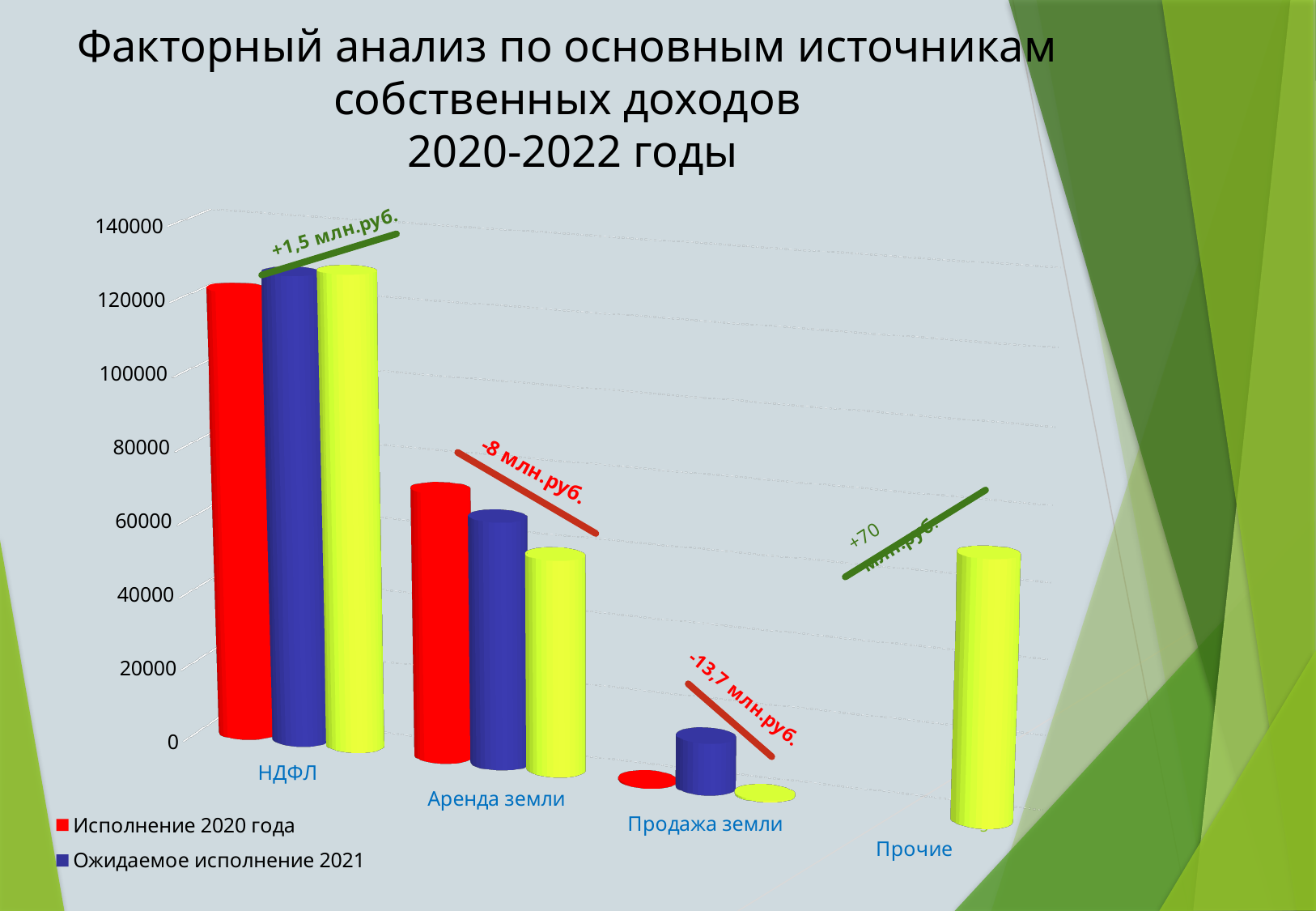
Do the values for Исполнение 2020 года rise or fall from НДФЛ to Продажа земли? fall For Аренда земли, which series has the larger value: Исполнение 2020 года or Ожидаемое исполнение 2021? Исполнение 2020 года How many series does the chart's legend list? 2 Is the value for Аренда земли in Исполнение 2020 года greater or less than 80000? less How many categories are shown on the x axis of the chart? 4 Which category has the highest value for Исполнение 2020 года? НДФЛ Which category has the lowest value for Исполнение 2020 года? Продажа земли Is the value for НДФЛ in Исполнение 2020 года greater or less than 100000? greater What annotation is written above the НДФЛ bars? +1,5 млн.руб. What kind of chart is shown on the slide? bar chart What annotation is written above the Продажа земли bars? -13,7 млн.руб. Is the value for Продажа земли in Ожидаемое исполнение 2021 greater or less than 20000? less